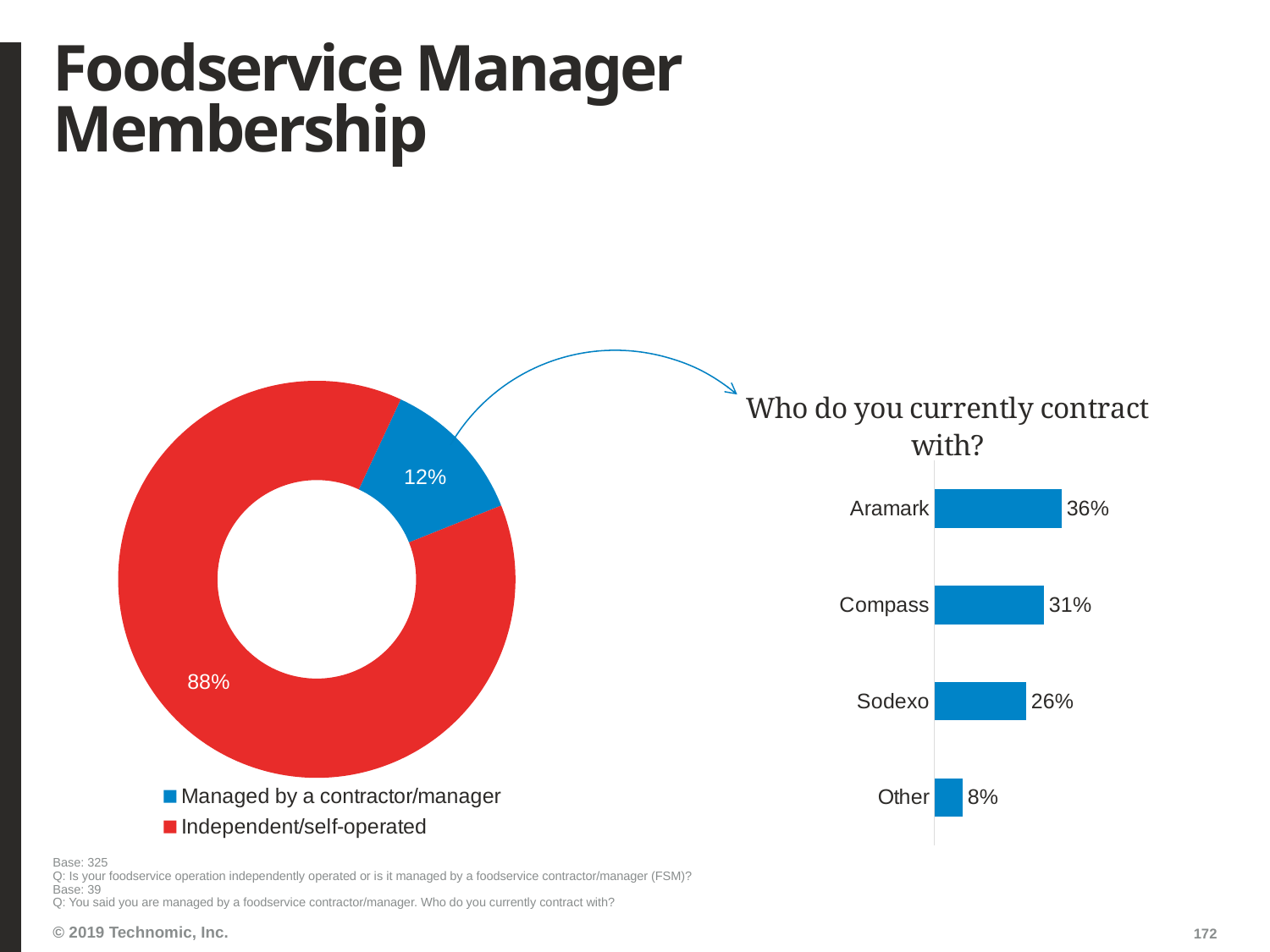
In the 'Who do you currently contract with?' chart, which category has the lowest value? Other In the donut chart on the left, what percentage is Managed by a contractor/manager? 12% In the 'Who do you currently contract with?' chart, which is larger, Compass or Sodexo? Compass In the donut chart on the left, what colour is the Independent/self-operated segment? Red In the donut chart on the left, what percentage is Independent/self-operated? 88% What kind of chart is the 'Who do you currently contract with?' chart? Bar chart In the 'Who do you currently contract with?' chart, what is the difference between Aramark and Compass? 5% How many categories are shown in the 'Who do you currently contract with?' chart? 4 In the 'Who do you currently contract with?' chart, which category has the highest value? Aramark How many entries does the legend of the donut chart on the left list? 2 In the 'Who do you currently contract with?' chart, what is the value for Sodexo? 26% In the 'Who do you currently contract with?' chart, what is the value for Aramark? 36%